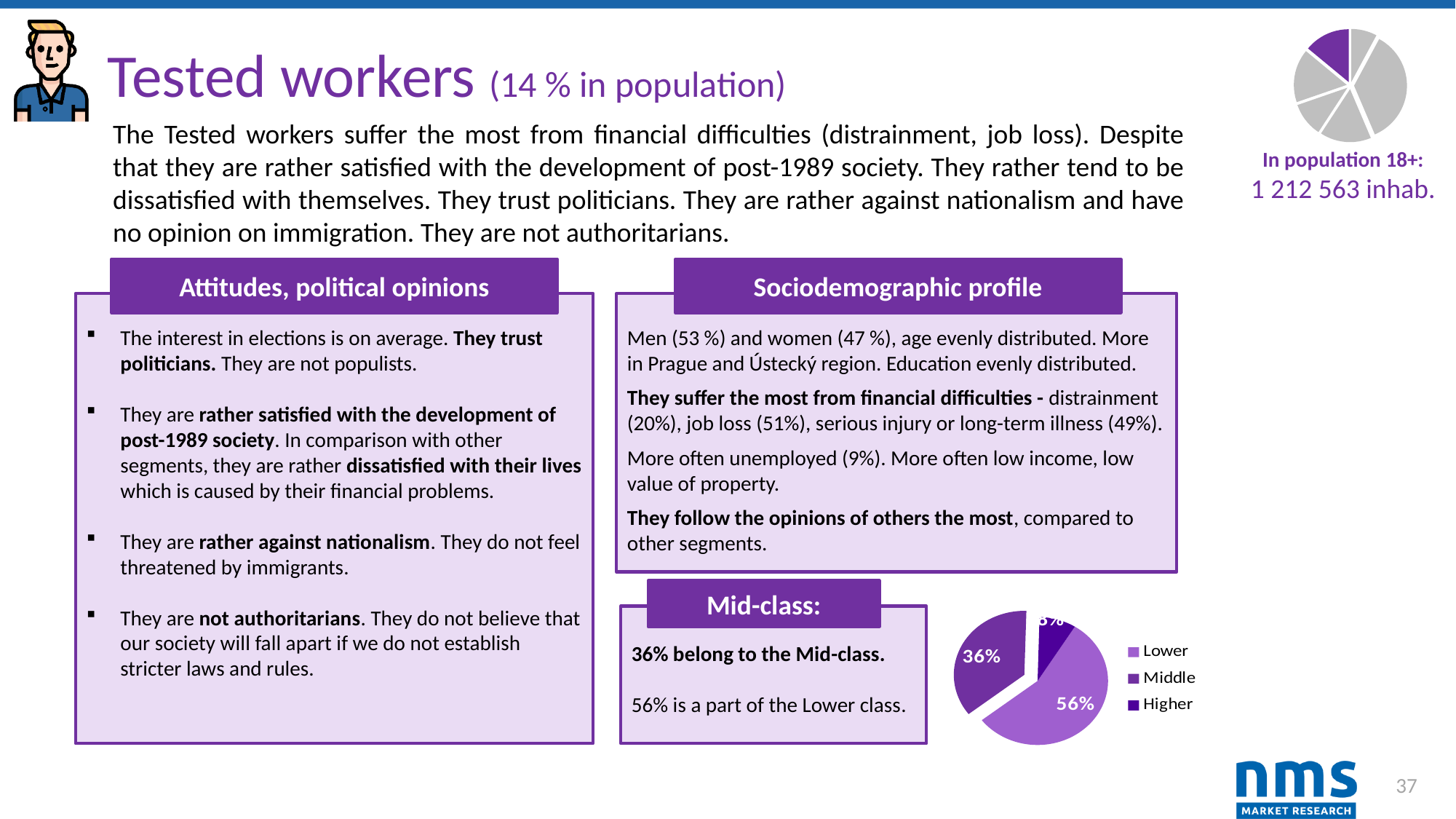
In the pie chart at the bottom right, what is the value for Lower? 56% How many categories does the legend of the pie chart at the bottom right list? 3 In the pie chart at the bottom right, what is the difference between the Lower and Middle values? 20 percentage points In the pie chart at the bottom right, which is larger, Lower or Middle? Lower In the pie chart at the bottom right, what is the value for Middle? 36% In the pie chart at the bottom right, which category has the smallest slice? Higher What are the legend entries of the pie chart at the bottom right? Lower, Middle, Higher In the pie chart at the bottom right, what share of the pie does the Middle slice represent? 36% What kind of chart is shown at the bottom right of the slide next to the Mid-class box? Pie chart In the pie chart at the bottom right, is the Lower slice more or less than half of the pie? More In the pie chart at the bottom right, which category has the largest slice? Lower